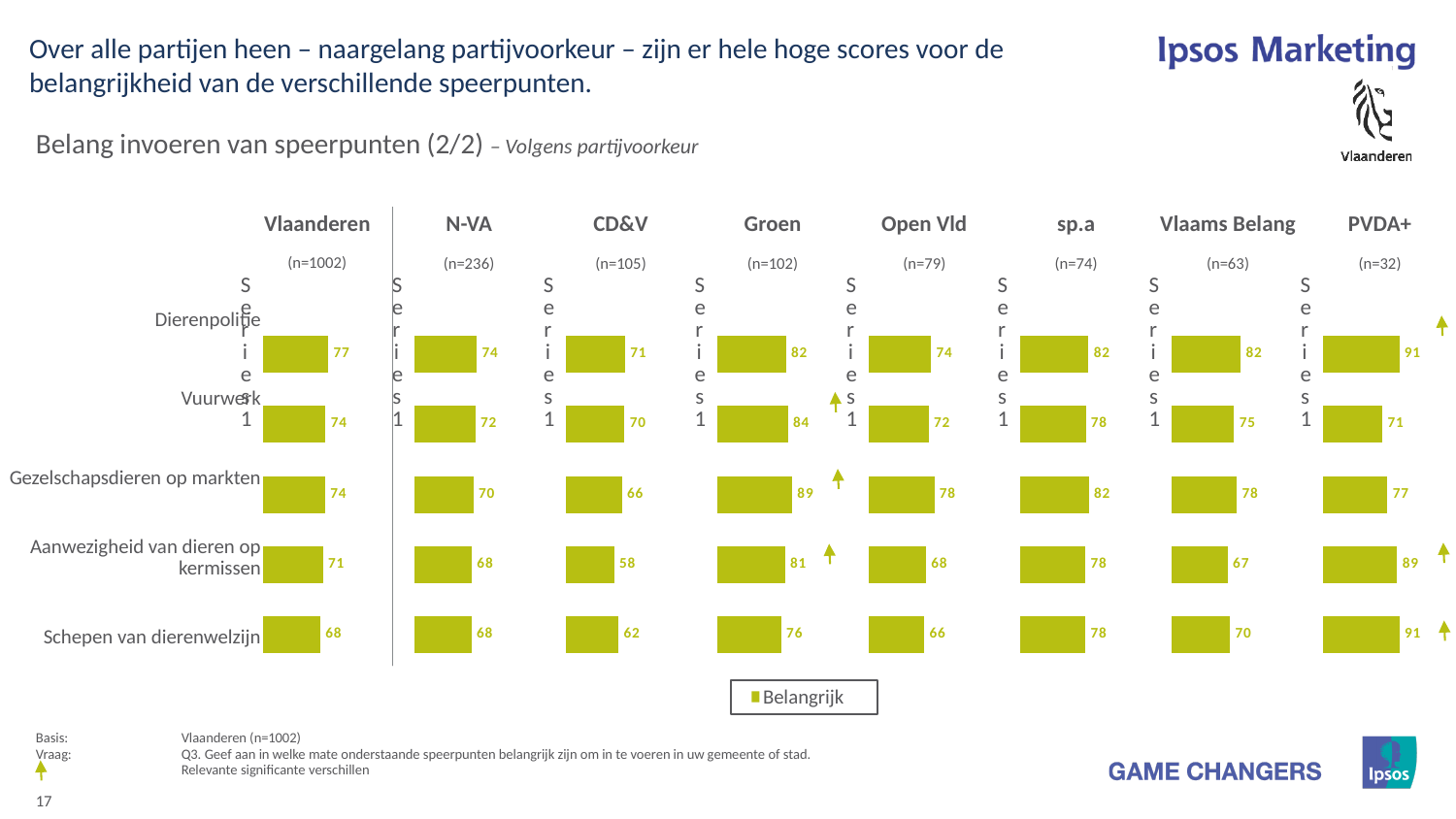
What kind of chart is used for each party? Bar chart In the Open Vld chart, what is the value for Aanwezigheid van dieren op kermissen? 68 In the Groen chart, what is the value for Gezelschapsdieren op markten? 89 In the N-VA chart, what is the difference between the value for Dierenpolitie and the value for Schepen van dierenwelzijn? 6 In the Vlaanderen chart, what is the value for Dierenpolitie? 77 How many categories are shown in each party chart? 5 In the CD&V chart, which category has the lowest value? Aanwezigheid van dieren op kermissen Which is larger: the value for Schepen van dierenwelzijn in the sp.a chart or in the Vlaams Belang chart? sp.a What is the legend entry shown below the charts? Belangrijk How many series does the legend list? 1 In the PVDA+ chart, what is the difference between the value for Dierenpolitie and the value for Vuurwerk? 20 In the Groen chart, which category has the highest value? Gezelschapsdieren op markten